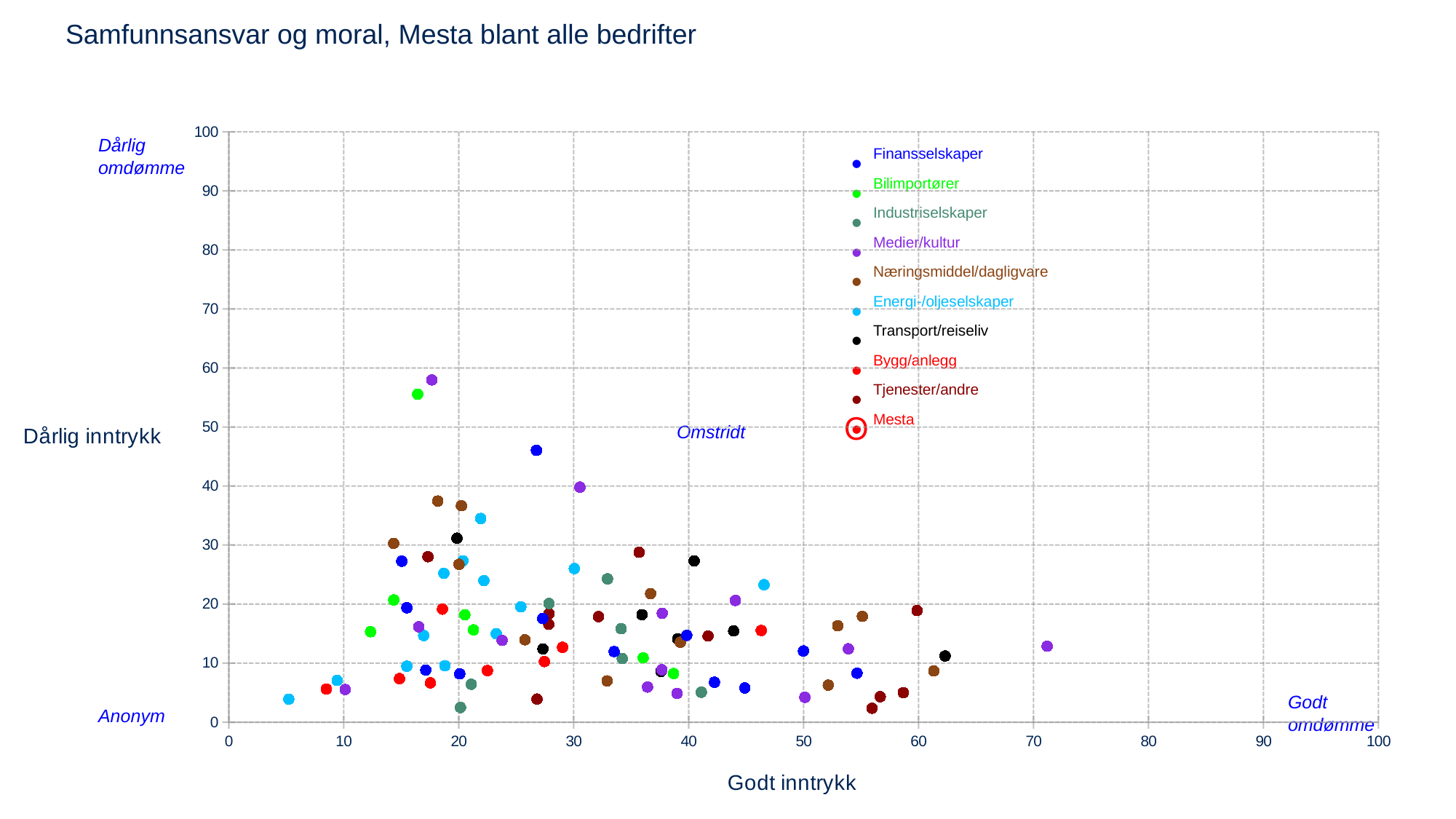
How many entries does the legend list? 10 What is the title of the chart? Samfunnsansvar og moral, Mesta blant alle bedrifter Is the vertical value of the highest Bilimportører point greater or less than 50? greater Which series does the point farthest to the right on the chart belong to? Medier/kultur What kind of chart is shown on the slide? Scatter chart Is the horizontal value of the leftmost point on the chart greater or less than 10? less What is the label of the horizontal axis? Godt inntrykk Which is farther to the right: the rightmost Medier/kultur point or the rightmost Transport/reiseliv point? Medier/kultur Is the vertical value of the highest Finansselskaper point greater or less than 40? greater Which series does the leftmost point on the chart belong to? Energi-/oljeselskaper